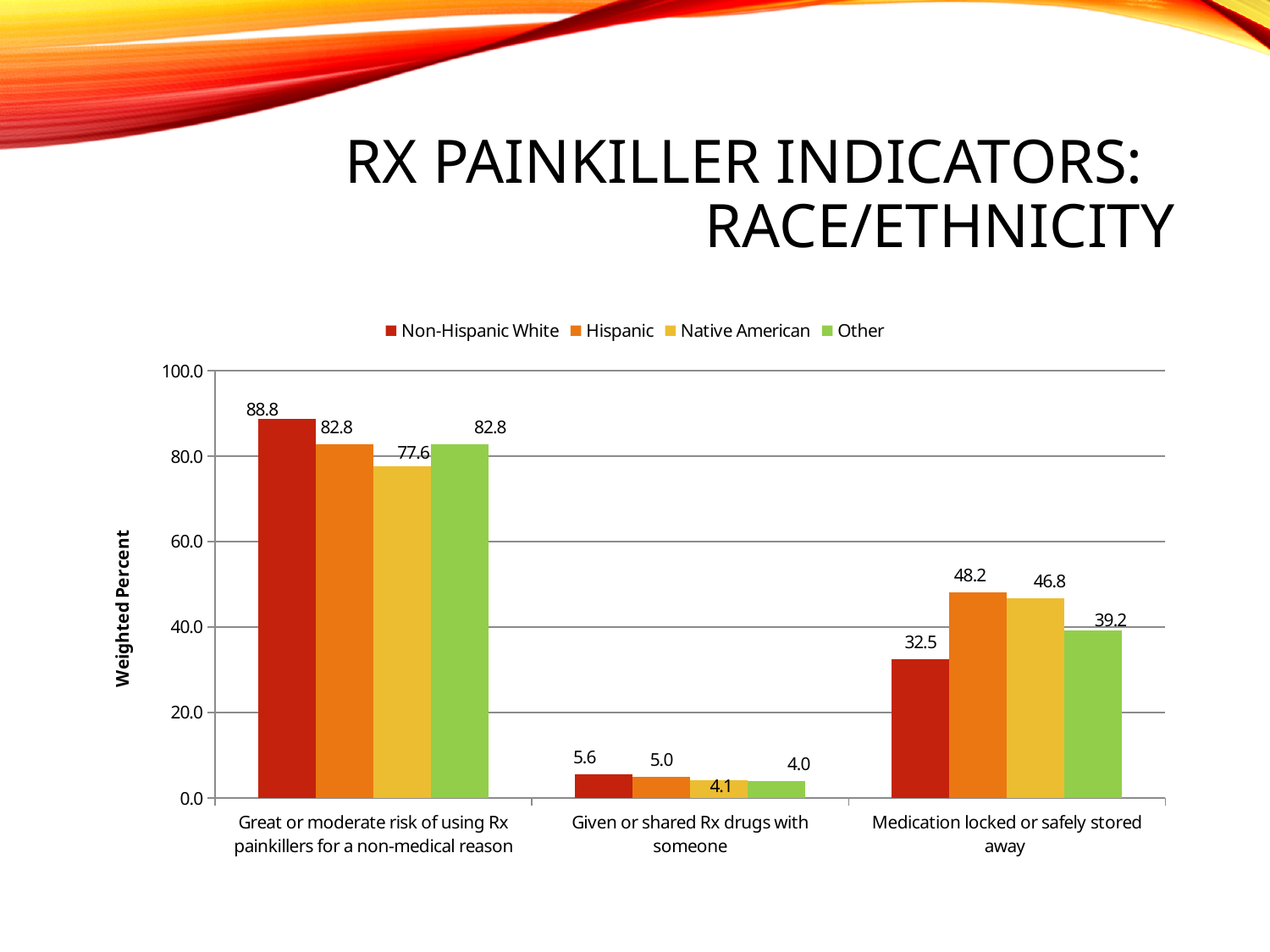
What is the value for Non-Hispanic White in the 'Great or moderate risk of using Rx painkillers for a non-medical reason' category? 88.8 Which group has the lowest value in the 'Great or moderate risk of using Rx painkillers for a non-medical reason' category? Native American What kind of chart is shown on the slide? Bar chart What is the label of the y axis? Weighted Percent What is the value for Other in the 'Given or shared Rx drugs with someone' category? 4.0 Is the value for Other in the 'Medication locked or safely stored away' category greater or less than 40.0? less What is the difference between the Hispanic and Non-Hispanic White values in the 'Medication locked or safely stored away' category? 15.7 What is the value for Native American in the 'Medication locked or safely stored away' category? 46.8 Which group has the highest value in the 'Medication locked or safely stored away' category? Hispanic Which is larger in the 'Given or shared Rx drugs with someone' category: Non-Hispanic White or Hispanic? Non-Hispanic White How many categories are shown on the x axis? 3 How many series does the legend list? 4